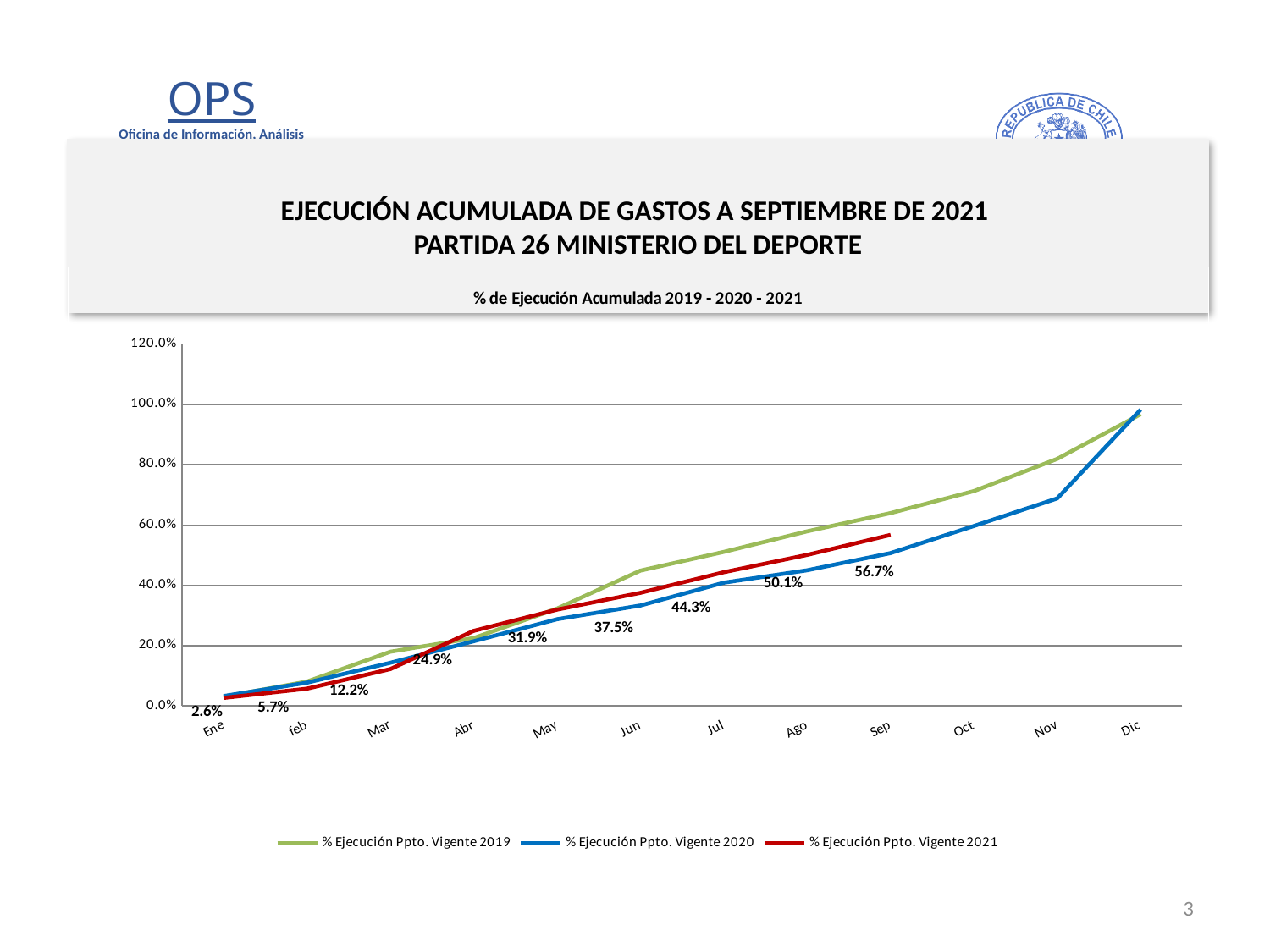
What is the value of % Ejecución Ppto. Vigente 2021 for Abr? 24.9% What is the value of % Ejecución Ppto. Vigente 2021 for Ene? 2.6% What type of chart is shown on the slide? line chart Which colour is used for the % Ejecución Ppto. Vigente 2021 line? red How many series does the legend list? 3 What is the value of % Ejecución Ppto. Vigente 2021 for Sep? 56.7% Do the values of % Ejecución Ppto. Vigente 2021 rise or fall from Ene to Sep? rise What is the difference between the 2021 values for Jul and Jun? 6.8% How many months are shown along the x axis? 12 Is the value for % Ejecución Ppto. Vigente 2019 in Nov greater or less than 60.0%? greater What is the difference between the 2021 values for Sep and Ago? 6.6%